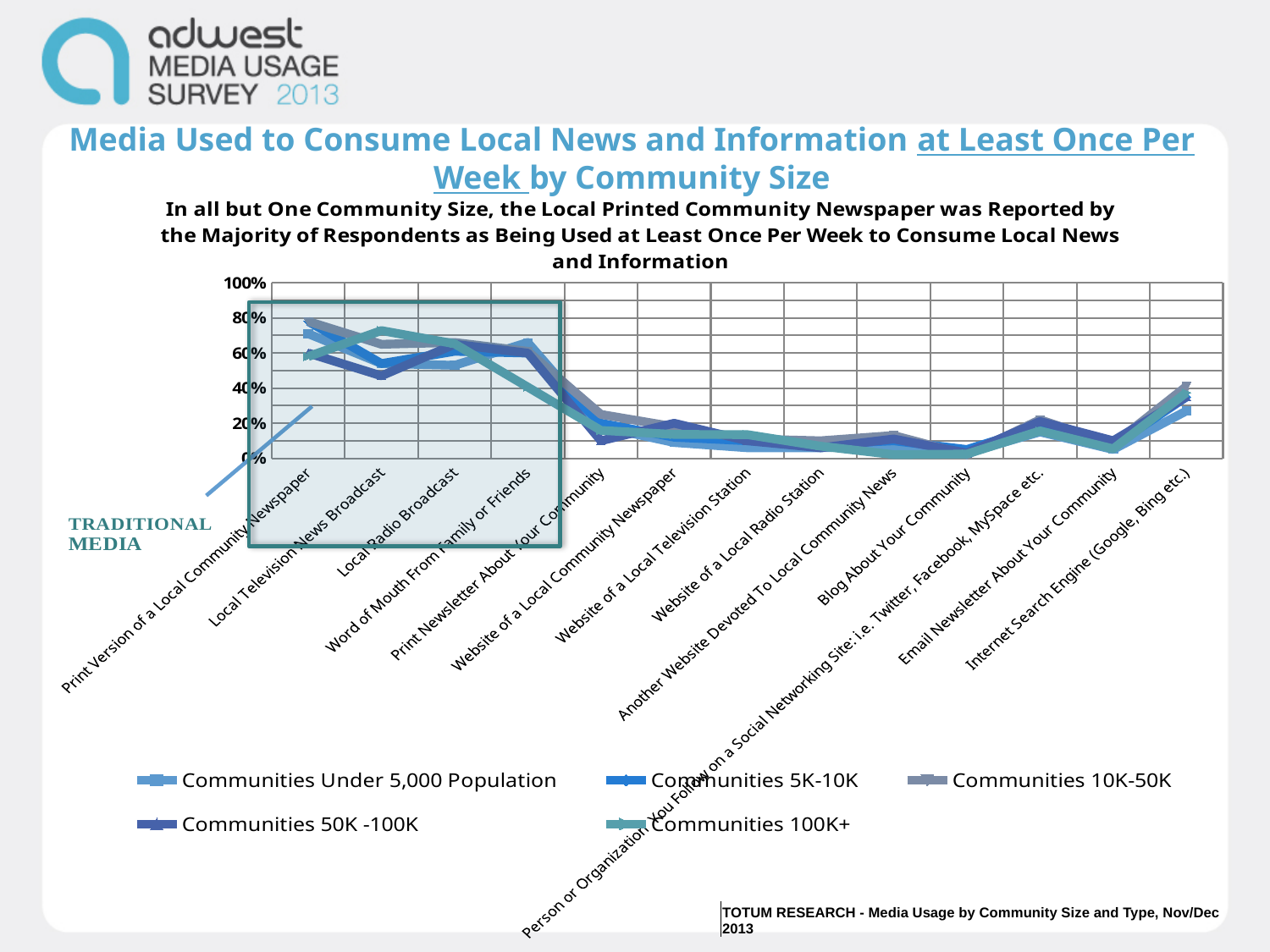
What label is attached to the boxed group of the first four categories on the chart? TRADITIONAL MEDIA Is the value for Blog About Your Community for Communities 100K+ greater or less than 20%? less How many series does the legend list? 5 What kind of chart is shown on the slide? line chart Is the value for Website of a Local Radio Station for Communities 5K-10K greater or less than 20%? less Is the value for Internet Search Engine (Google, Bing etc.) for Communities 10K-50K greater or less than 20%? greater How many media categories are plotted along the x axis? 13 For Communities 100K+, which is larger: the value for Internet Search Engine (Google, Bing etc.) or the value for Blog About Your Community? Internet Search Engine (Google, Bing etc.) For Communities 50K -100K, which is larger: the value for Print Version of a Local Community Newspaper or the value for Website of a Local Community Newspaper? Print Version of a Local Community Newspaper Which community size series are listed in the legend? Communities Under 5,000 Population, Communities 5K-10K, Communities 10K-50K, Communities 50K -100K, Communities 100K+ Do the values generally rise or fall along the x axis from Print Version of a Local Community Newspaper to Blog About Your Community? fall